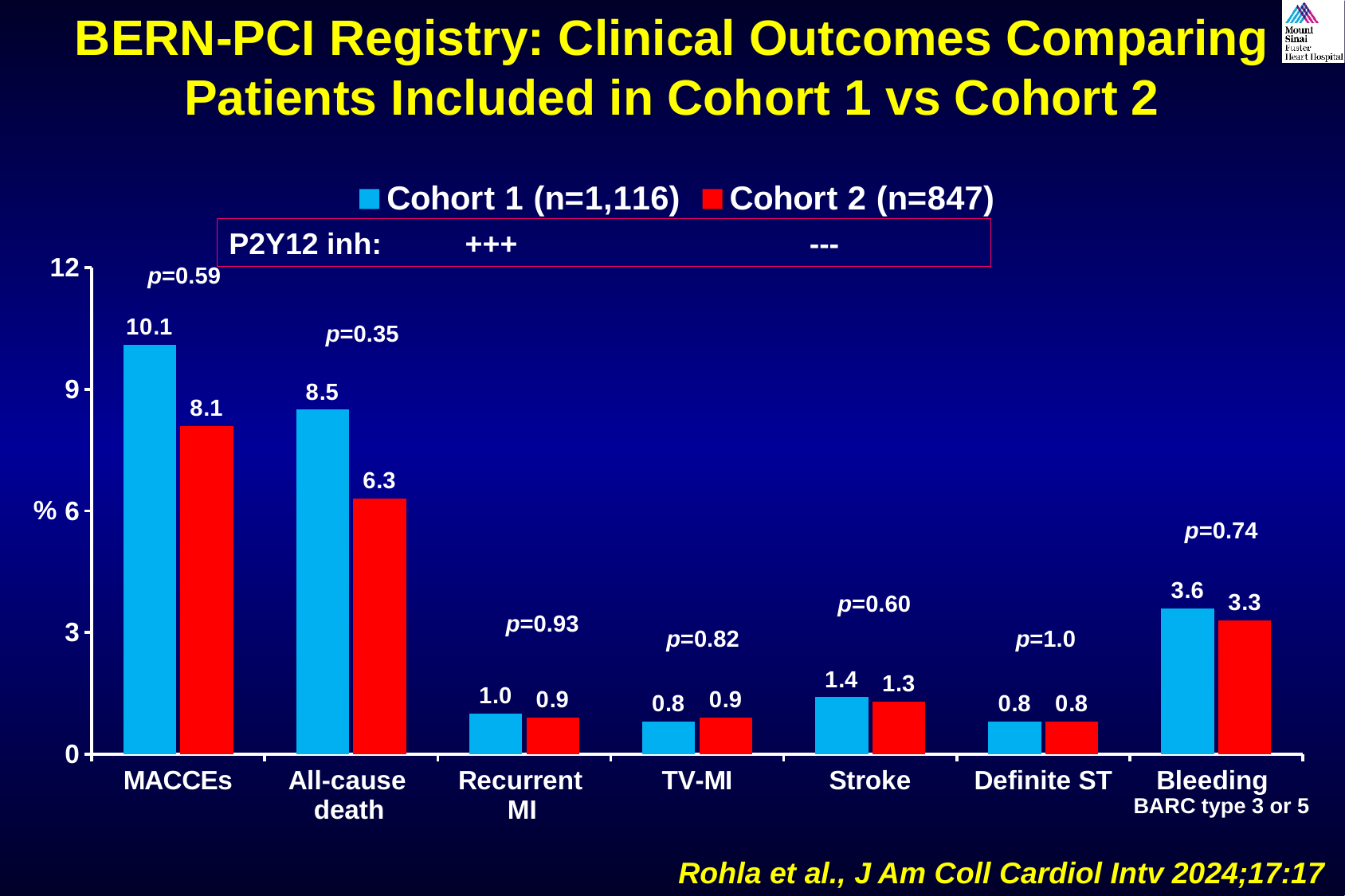
Which category has the lowest value for Cohort 2? Definite ST What is the difference between Cohort 1 and Cohort 2 in the MACCEs category? 2.0 What is the value for Cohort 1 in the MACCEs category? 10.1 Is the value for Cohort 1 in the All-cause death category greater or less than 9? less Which category has the highest value for Cohort 1? MACCEs What is the difference between Cohort 1 and Cohort 2 in the All-cause death category? 2.2 How many series does the legend list? 2 Which cohort has the larger value in the TV-MI category? Cohort 2 What kind of chart is shown on the slide? bar chart What is the value for Cohort 2 in the All-cause death category? 6.3 What is the value for Cohort 2 in the Bleeding category? 3.3 How many outcome categories are shown on the x axis? 7